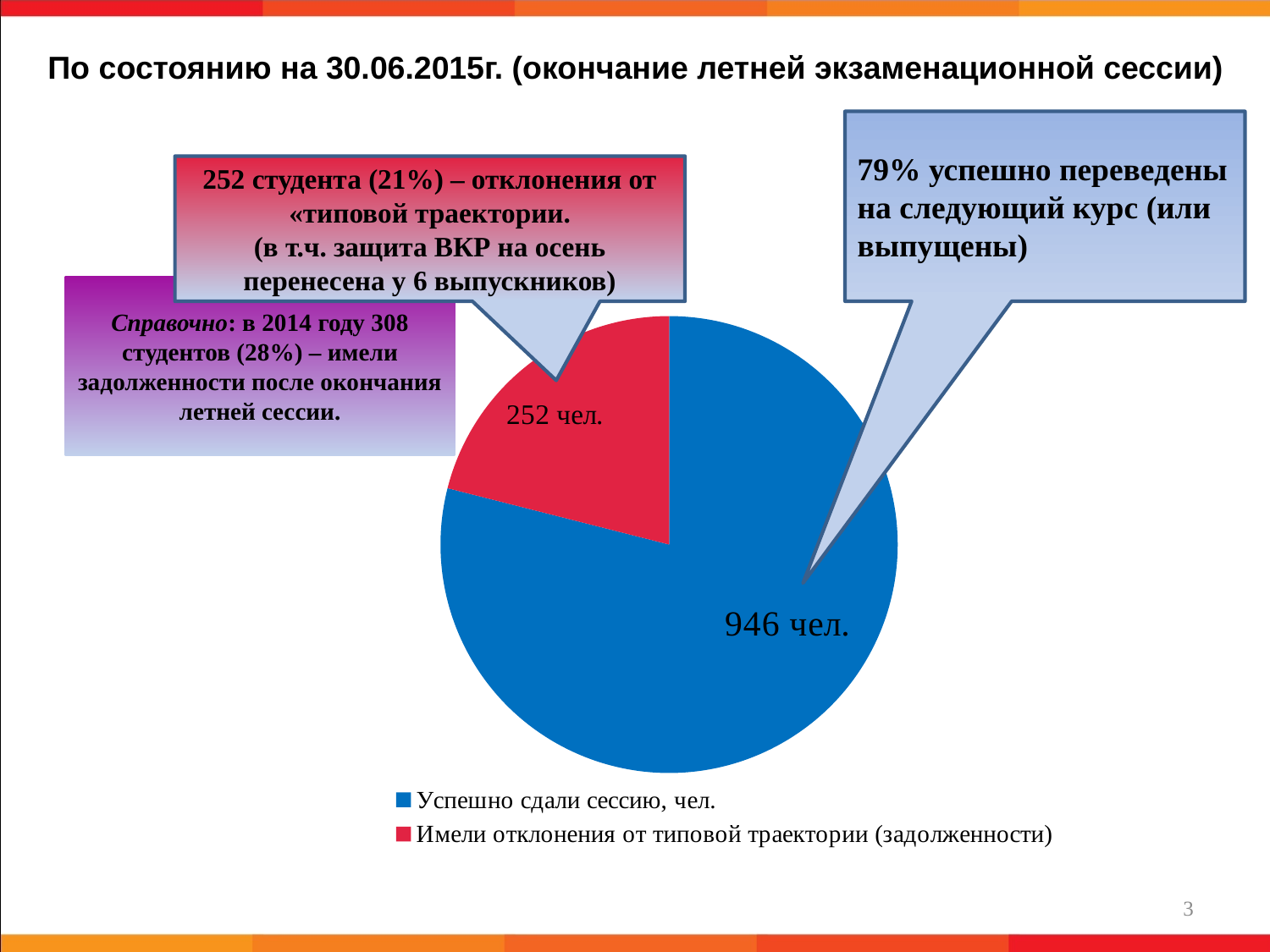
What kind of chart is shown on the slide? pie chart What is the total number of students represented in the pie chart? 1198 How many slices does the pie chart have? 2 Which slice of the pie chart is the smallest? Имели отклонения от типовой траектории (задолженности) What is the difference between the number of students who successfully passed the session and those who had deviations from the typical trajectory? 694 How many entries does the legend of the pie chart list? 2 What colour is the slice for "Успешно сдали сессию, чел." in the pie chart? blue Which is larger: the slice for "Успешно сдали сессию, чел." or the slice for "Имели отклонения от типовой траектории (задолженности)"? Успешно сдали сессию, чел. Which slice of the pie chart is the largest? Успешно сдали сессию, чел. What is the value for "Успешно сдали сессию, чел." in the pie chart? 946 чел. What share of the pie does the "Имели отклонения от типовой траектории (задолженности)" slice represent? 21% What is the value for "Имели отклонения от типовой траектории (задолженности)" in the pie chart? 252 чел.